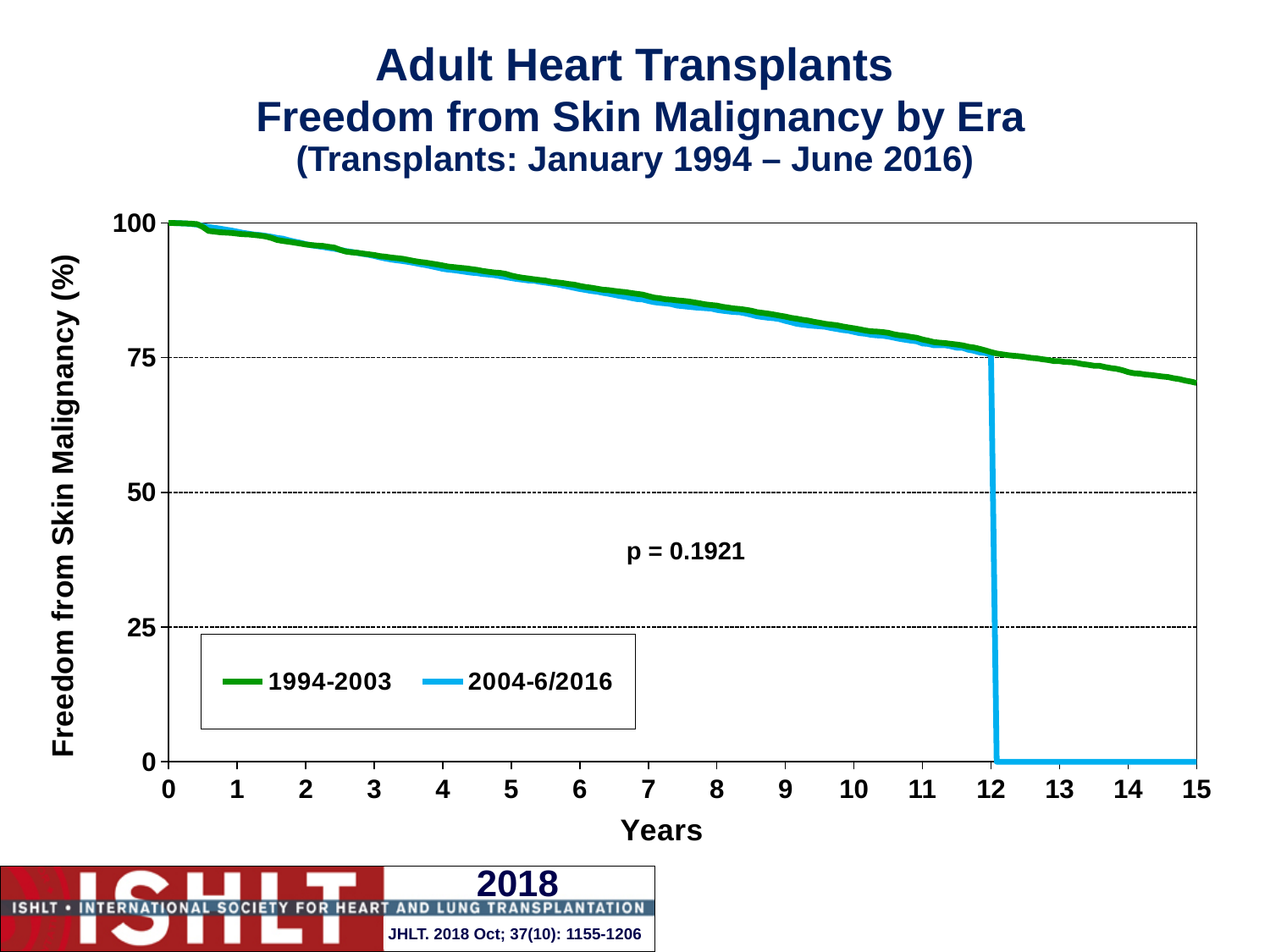
What is the label of the y axis? Freedom from Skin Malignancy (%) What is the highest value shown on the x axis? 15 What are the two series named in the legend? 1994-2003 and 2004-6/2016 Is the value for the 1994-2003 series at year 5 greater or less than 75? greater How many series does the legend list? 2 At year 14, which series has the larger value, 1994-2003 or 2004-6/2016? 1994-2003 Is the value for the 1994-2003 series at year 15 greater or less than 75? less What value does the 2004-6/2016 line show at year 14? 0 Is the value for the 2004-6/2016 series at year 10 greater or less than 75? greater Does the 1994-2003 line rise or fall as years increase from 0 to 15? Fall What kind of chart is shown on the slide? Line chart